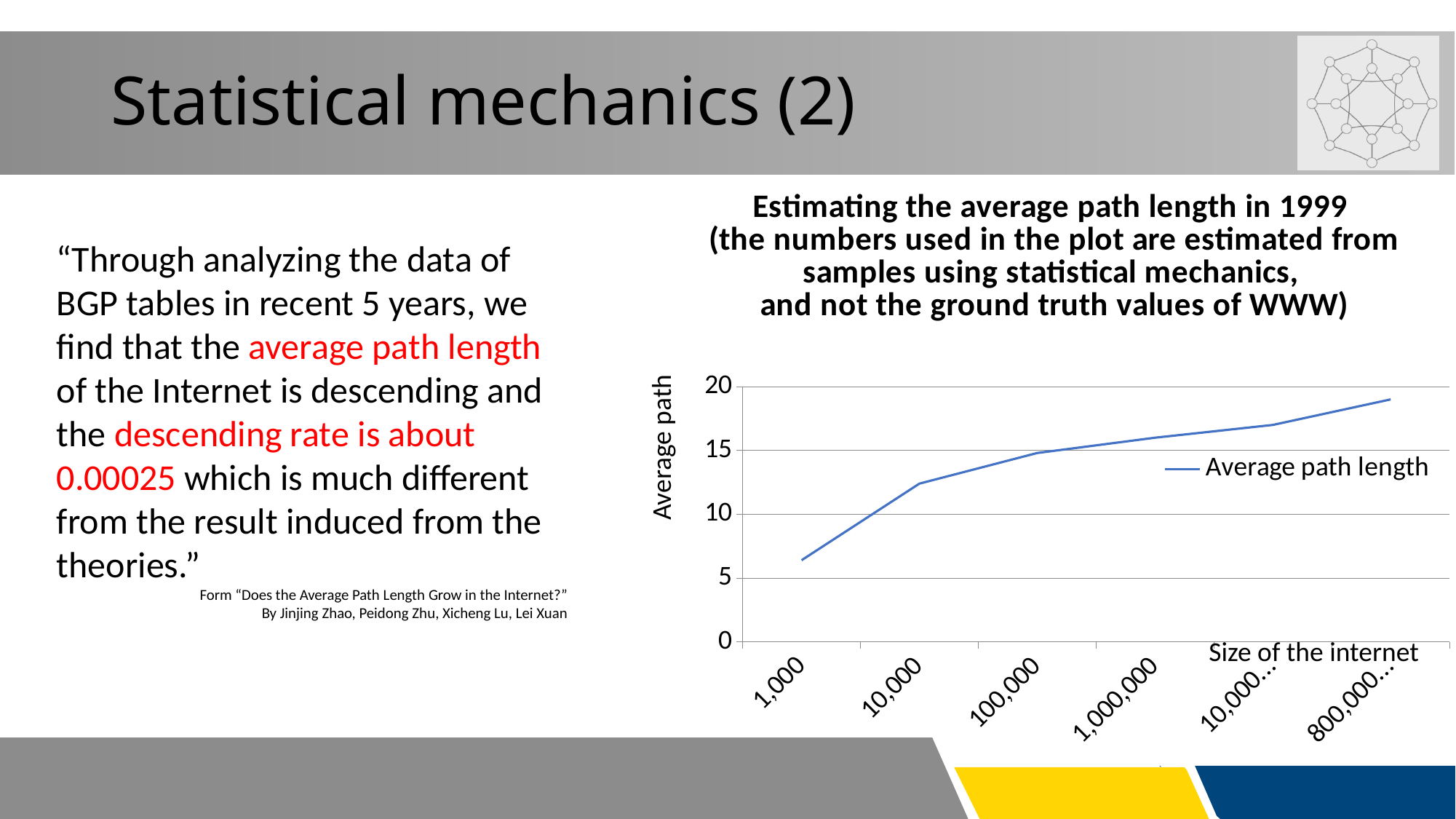
Does the average path length rise or fall as the size of the internet increases along the x axis? rise What is the label of the chart's x axis? Size of the internet How many data points are plotted on the line? 6 Which x-axis category has the lowest average path length? 1,000 Which has a larger average path length, 1,000 or 10,000? 10,000 How many series does the chart's legend list? 1 Is the average path length for 10,000 greater or less than 10? greater Is the average path length for 1,000 greater or less than 10? less Is the average path length for 1,000,000 greater or less than 15? greater What is the name of the series shown in the chart's legend? Average path length What kind of chart is shown on the slide? line chart